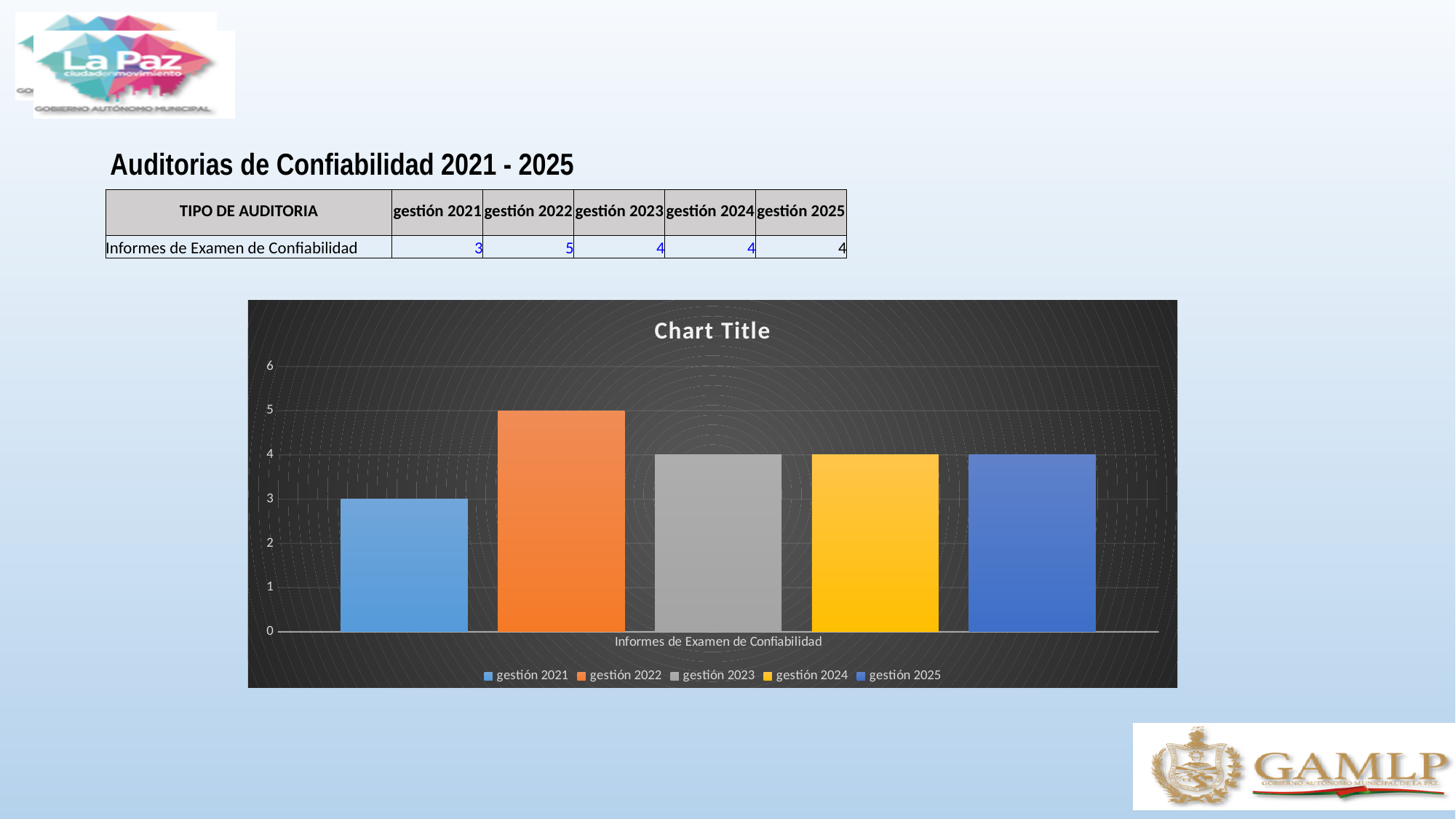
How many series does the legend list? 5 What kind of chart is shown on the slide? bar chart What is the value for gestión 2022 in the chart? 5 What is the title of the chart? Chart Title What is the difference between the values for gestión 2022 and gestión 2021? 2 What is the category label shown on the x axis of the chart? Informes de Examen de Confiabilidad Is the value for gestión 2021 greater or less than 4? less What is the value for gestión 2021 in the chart? 3 Which series has the highest value in the chart? gestión 2022 Which series has the lowest value in the chart? gestión 2021 What is the value for gestión 2023 in the chart? 4 Which is larger, the value for gestión 2022 or the value for gestión 2025? gestión 2022